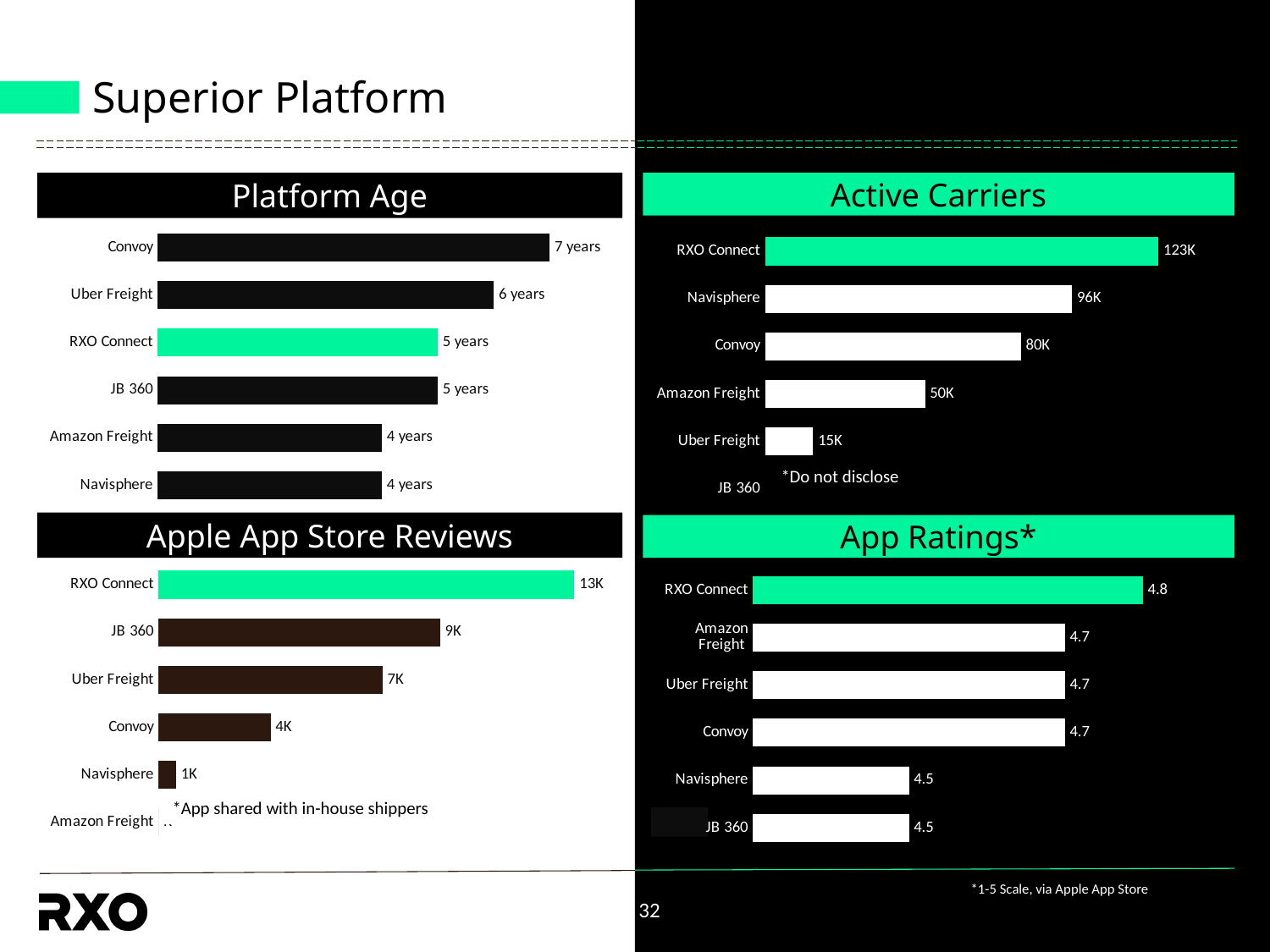
In the Active Carriers chart, what is shown for JB 360 instead of a value? *Do not disclose In the App Ratings chart, what is the rating for RXO Connect? 4.8 In the Apple App Store Reviews chart, which has more reviews, Uber Freight or Convoy? Uber Freight What type of chart is the App Ratings chart? Bar chart In the Active Carriers chart, which company has the fewest active carriers among those with a value shown? Uber Freight In the Active Carriers chart, how many active carriers does RXO Connect have? 123K In the Platform Age chart, what is the difference in years between Uber Freight and Amazon Freight? 2 years In the Apple App Store Reviews chart, how many reviews does JB 360 have? 9K In the Platform Age chart, how many years old is the Convoy platform? 7 years In the Apple App Store Reviews chart, which company has the most reviews? RXO Connect In the Active Carriers chart, what is the difference between Navisphere and Convoy? 16K In the Platform Age chart, which platform is the oldest? Convoy